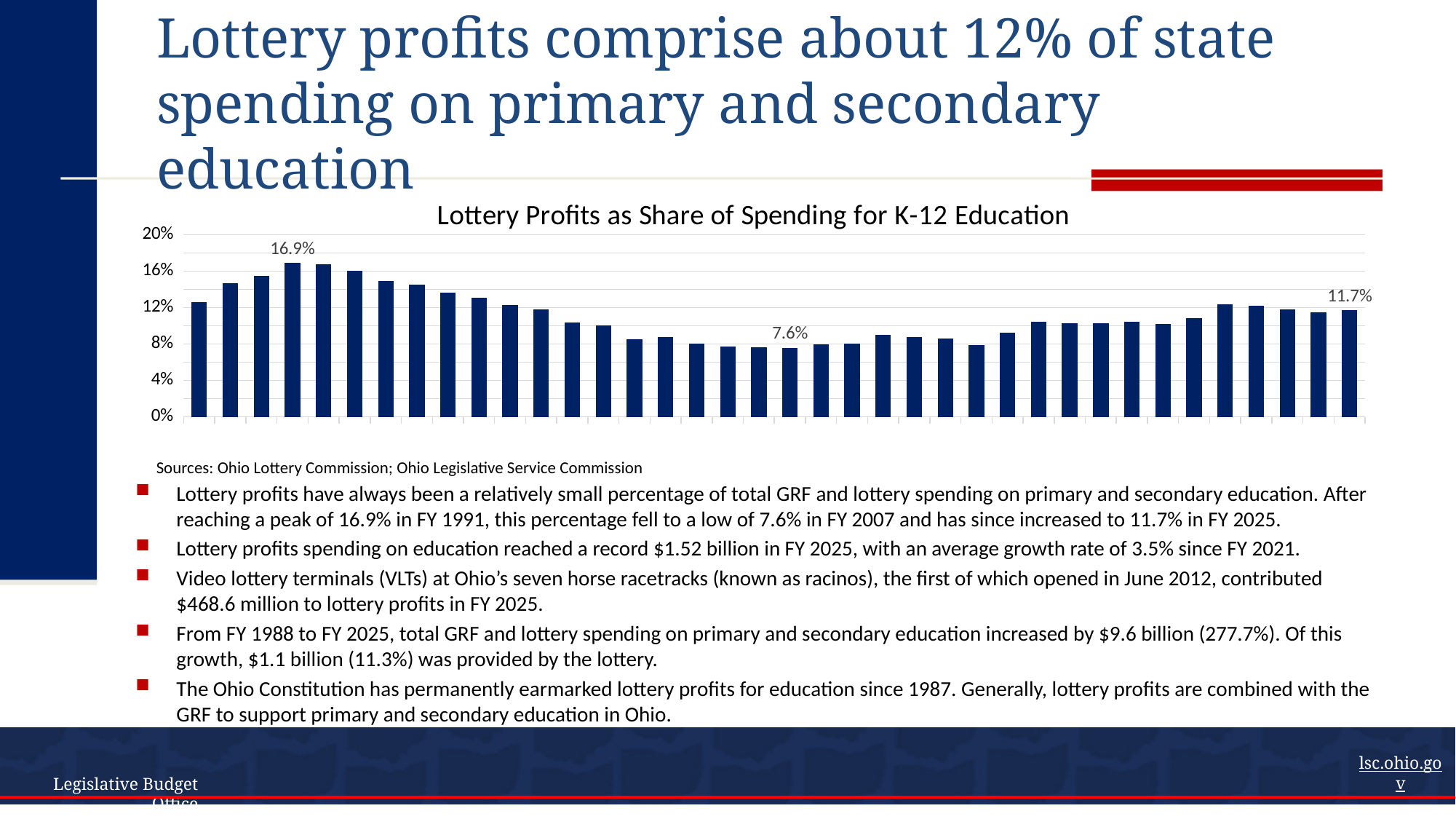
What value is labeled on the last (rightmost) bar of the chart? 11.7% How many bars are plotted on the chart? 38 Which is larger: the peak value labeled 16.9% or the final value labeled 11.7%? 16.9% Do the values rise or fall from the tallest bar (16.9%) to the shortest bar (7.6%) moving left to right? fall What is the highest value labeled on the chart? 16.9% What is the difference between the highest labeled value (16.9%) and the lowest labeled value (7.6%)? 9.3 percentage points What is the difference between the peak value of 16.9% and the final value of 11.7%? 5.2 percentage points What is the title of the chart? Lottery Profits as Share of Spending for K-12 Education Is the value of the tallest bar greater or less than 16%? greater What type of chart is shown on the slide? bar chart Is the value of the first (leftmost) bar greater or less than 8%? greater What is the lowest value labeled on the chart? 7.6%